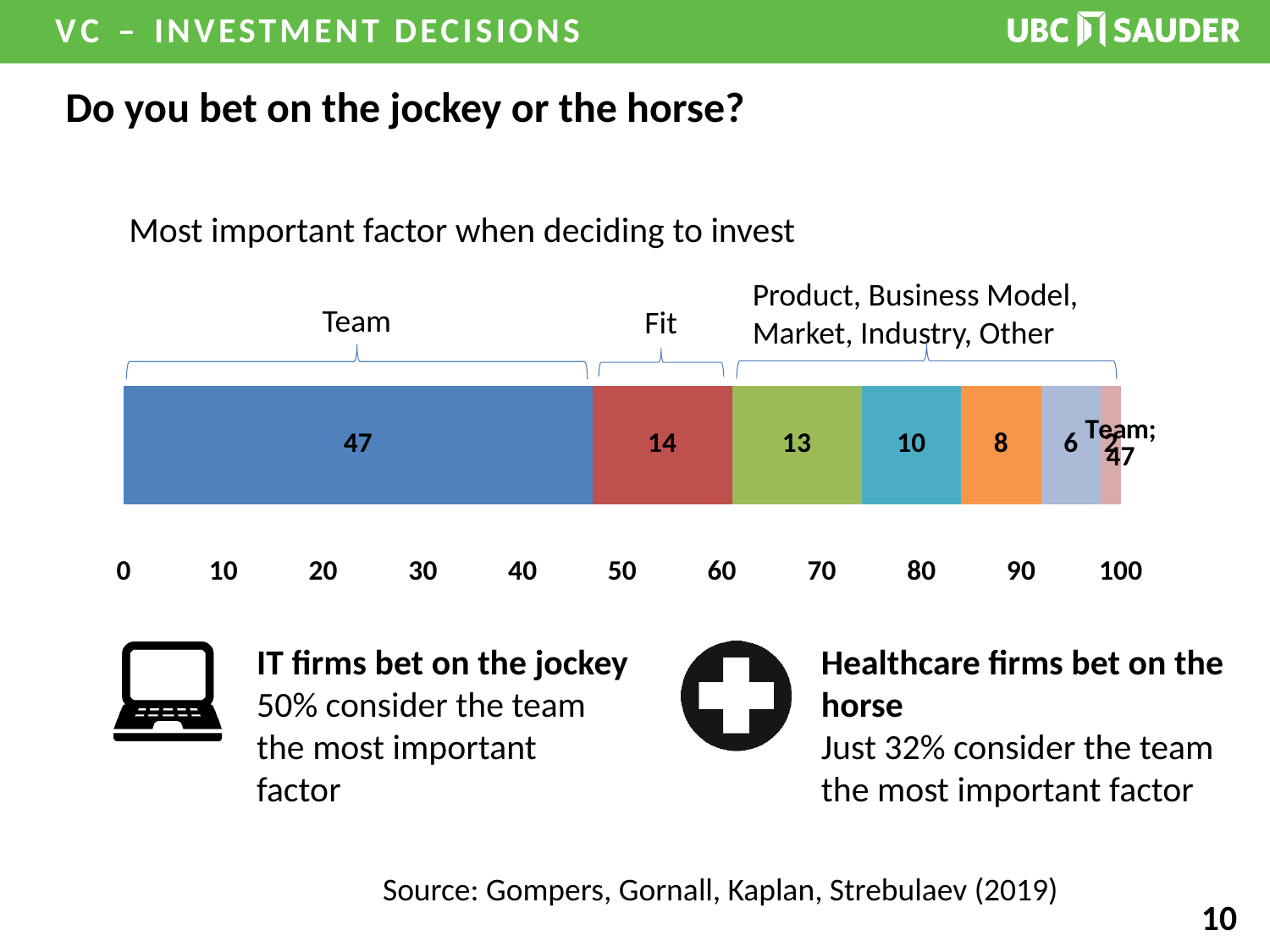
What is the difference between the Team value and the Fit value? 33 What is the value of the smallest segment in the stacked bar? 2 What is the total of all segments in the stacked bar? 100 What value is shown for the Team segment of the stacked bar? 47 How many segments fall under the bracket labelled 'Product, Business Model, Market, Industry, Other'? 5 Which is larger, the Team segment or the Fit segment? Team What is the combined value of the segments under 'Product, Business Model, Market, Industry, Other'? 39 What value is shown for the Fit segment of the stacked bar? 14 Is the value for Team greater or less than 40? greater How many segments make up the stacked bar? 7 What kind of chart is shown on the slide? Stacked bar chart Which labelled factor has the largest segment in the bar? Team